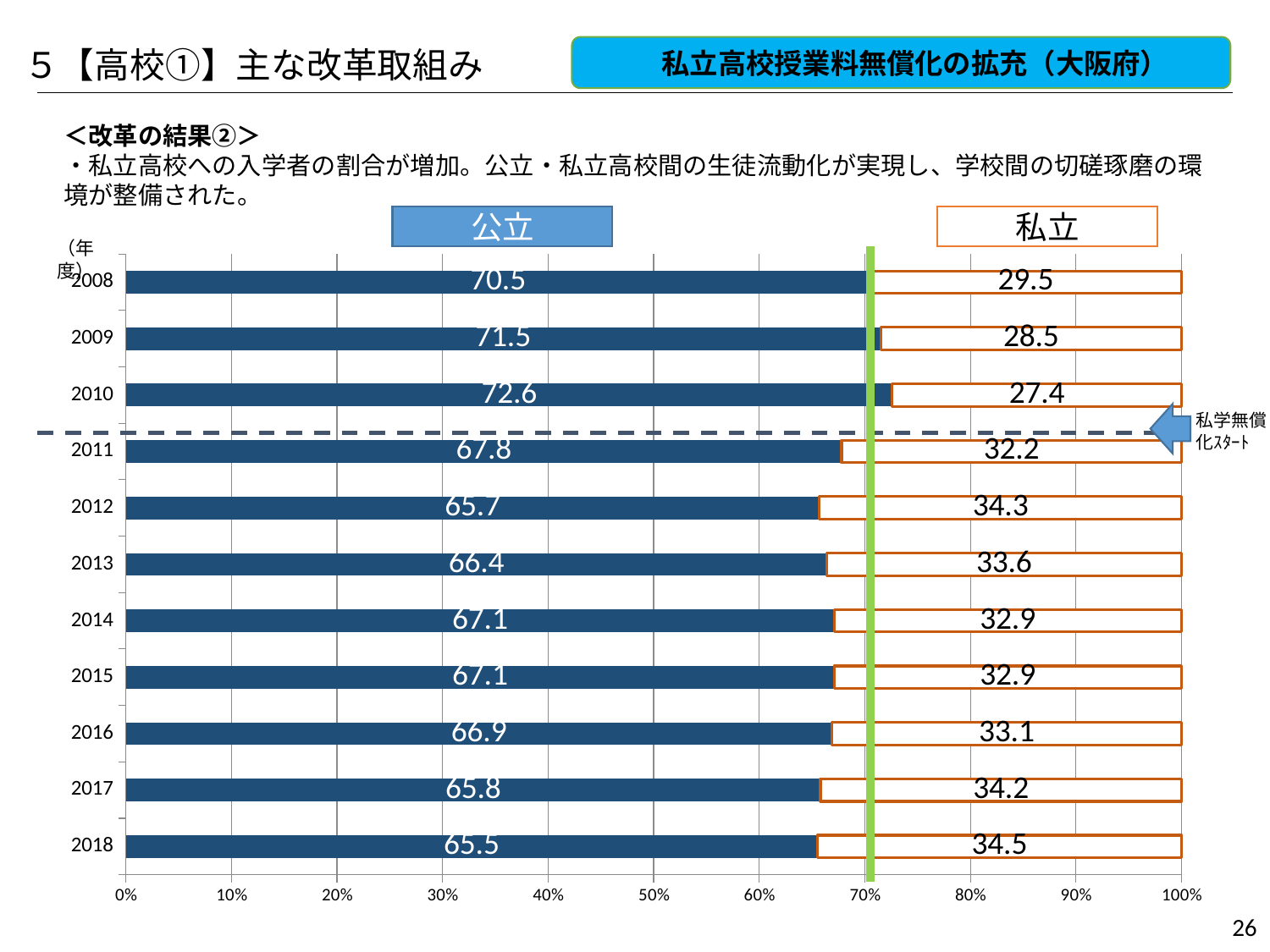
What is the total of the stacked bar for 2014? 100 What is the value for 私立 in 2011? 32.2 How many years are shown on the chart? 11 In which year is the 私立 value lowest? 2010 Is the 公立 value for 2018 greater or less than 70%? less What is the difference between the 私立 values for 2018 and 2008? 5.0 In which year is the 公立 value highest? 2010 What is the value for 私立 in 2018? 34.5 What is the value for 公立 in 2008? 70.5 How many series does the chart show? 2 What kind of chart is shown on the slide? Stacked bar chart Which is larger, the 公立 value for 2009 or the 公立 value for 2012? 2009